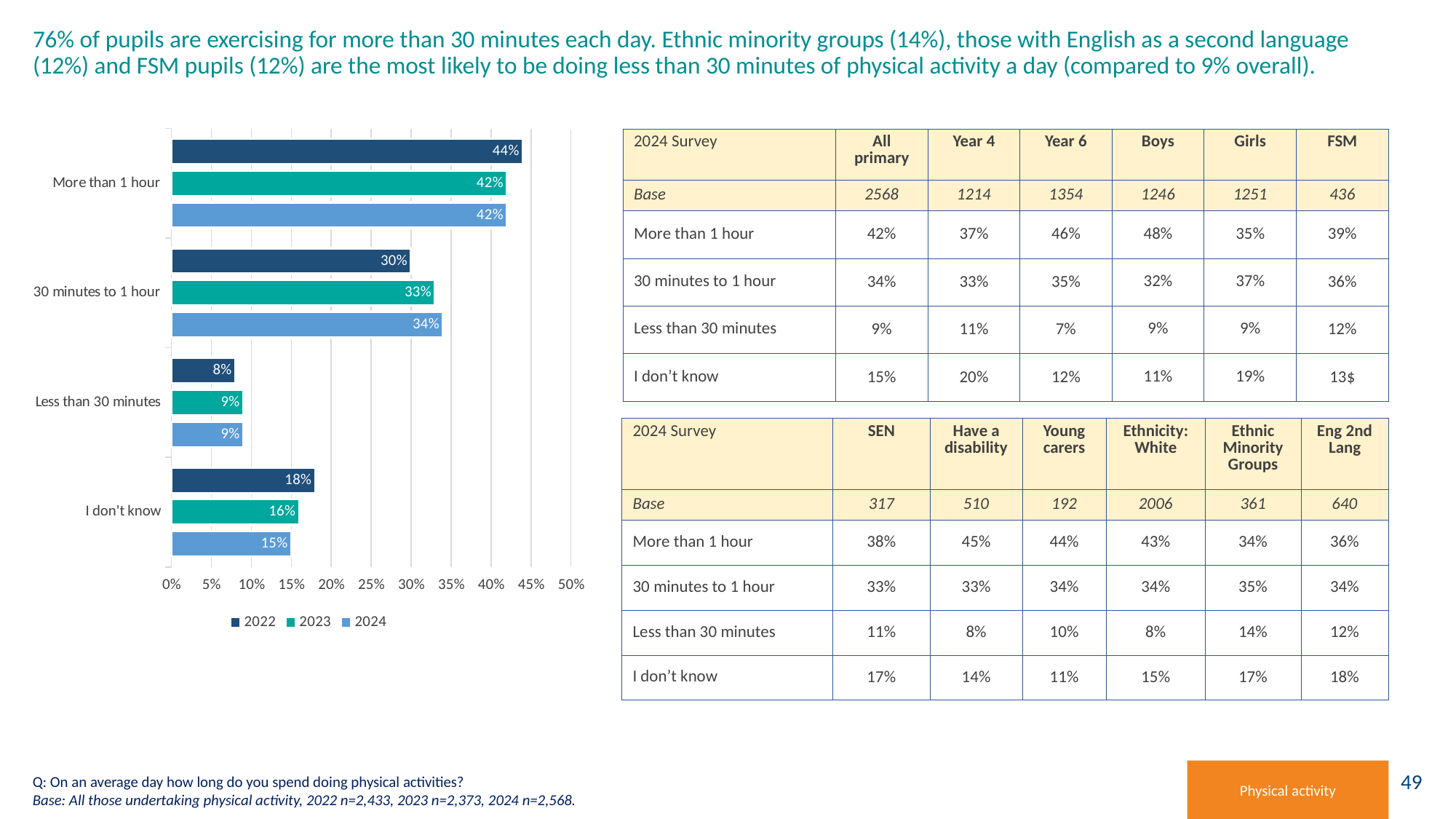
Which years are listed in the chart legend? 2022, 2023, 2024 What is the 2024 value for '30 minutes to 1 hour'? 34% What is the 2022 value for 'More than 1 hour'? 44% Which category has the lowest value for the 2022 series? Less than 30 minutes How many series does the legend list? 3 How many categories are shown on the chart? 4 What is the 2024 value for 'I don't know'? 15% What kind of chart is shown on the slide? Bar chart Which is larger for '30 minutes to 1 hour': the 2022 value or the 2023 value? 2023 What is the 2023 value for 'Less than 30 minutes'? 9% Which category has the highest value for the 2024 series? More than 1 hour What is the difference between the 2022 and 2024 values for 'More than 1 hour'? 2%